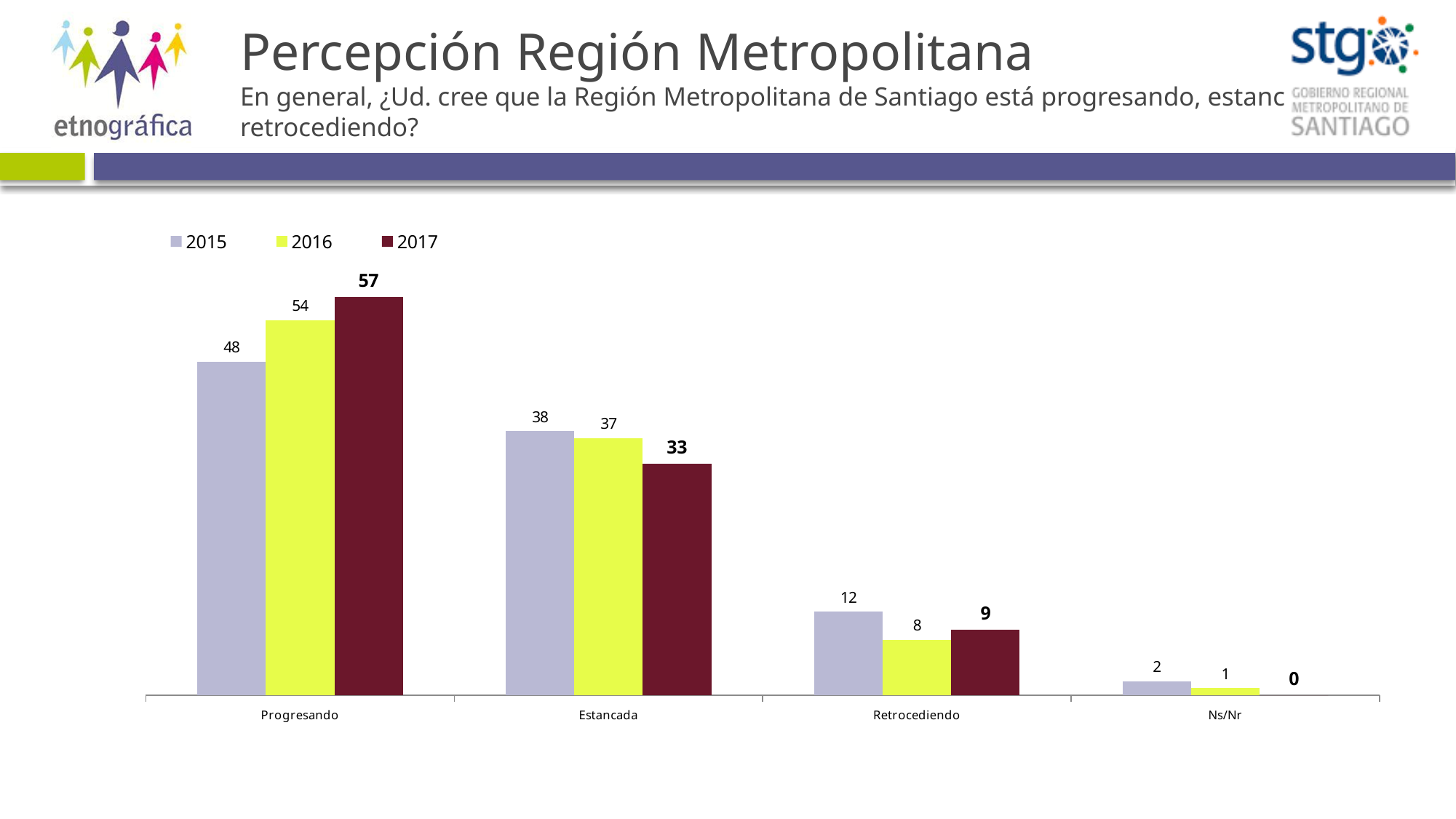
What is the value for Retrocediendo in 2016? 8 How many series does the legend list? 3 How many categories are shown on the x axis? 4 What is the value for Estancada in 2015? 38 Which category has the highest value in 2016? Progresando What is the value for Ns/Nr in 2017? 0 Which is larger for Estancada: the 2015 value or the 2017 value? 2015 What is the difference between the 2017 and 2015 values for Progresando? 9 Do the values for Estancada rise or fall from 2015 to 2017? Fall What is the value for Progresando in 2017? 57 What kind of chart is shown on the slide? Bar chart Which category has the lowest value in 2015? Ns/Nr